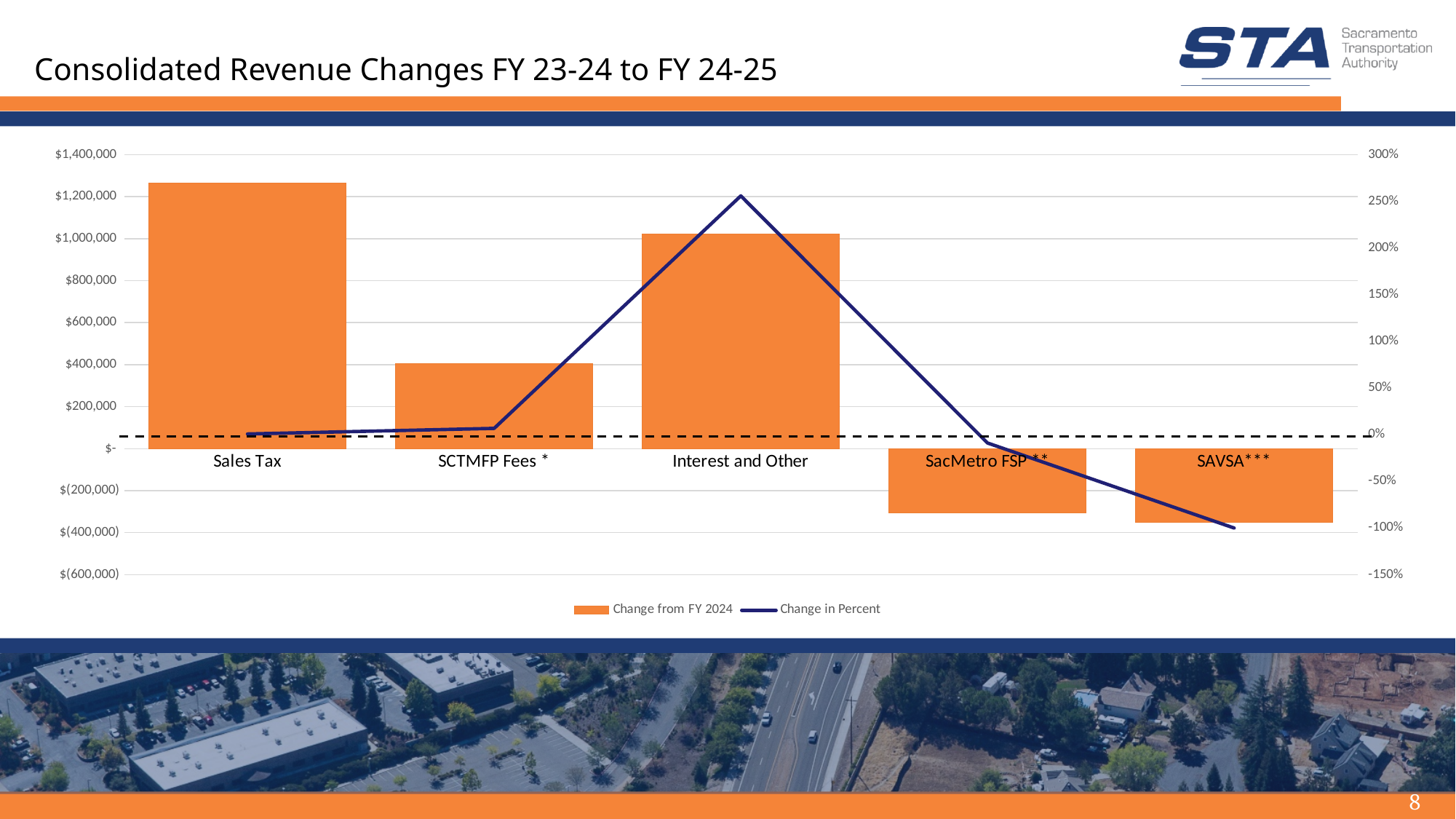
How many categories are shown on the x axis of the chart? 5 Is the Change from FY 2024 bar for SCTMFP Fees * greater or less than $600,000? less Which category has the highest point on the Change in Percent line? Interest and Other How many series does the chart legend list? 2 What kind of chart is shown on the slide? Combination bar and line chart Is the Change in Percent value for Interest and Other greater or less than 200%? greater Which has the larger Change from FY 2024 bar, Sales Tax or Interest and Other? Sales Tax Is the Change from FY 2024 bar for SacMetro FSP** greater or less than $(200,000)? less What are the two legend entries of the chart? Change from FY 2024; Change in Percent Which category has the lowest point on the Change in Percent line? SAVSA*** Which category has the highest bar for Change from FY 2024? Sales Tax